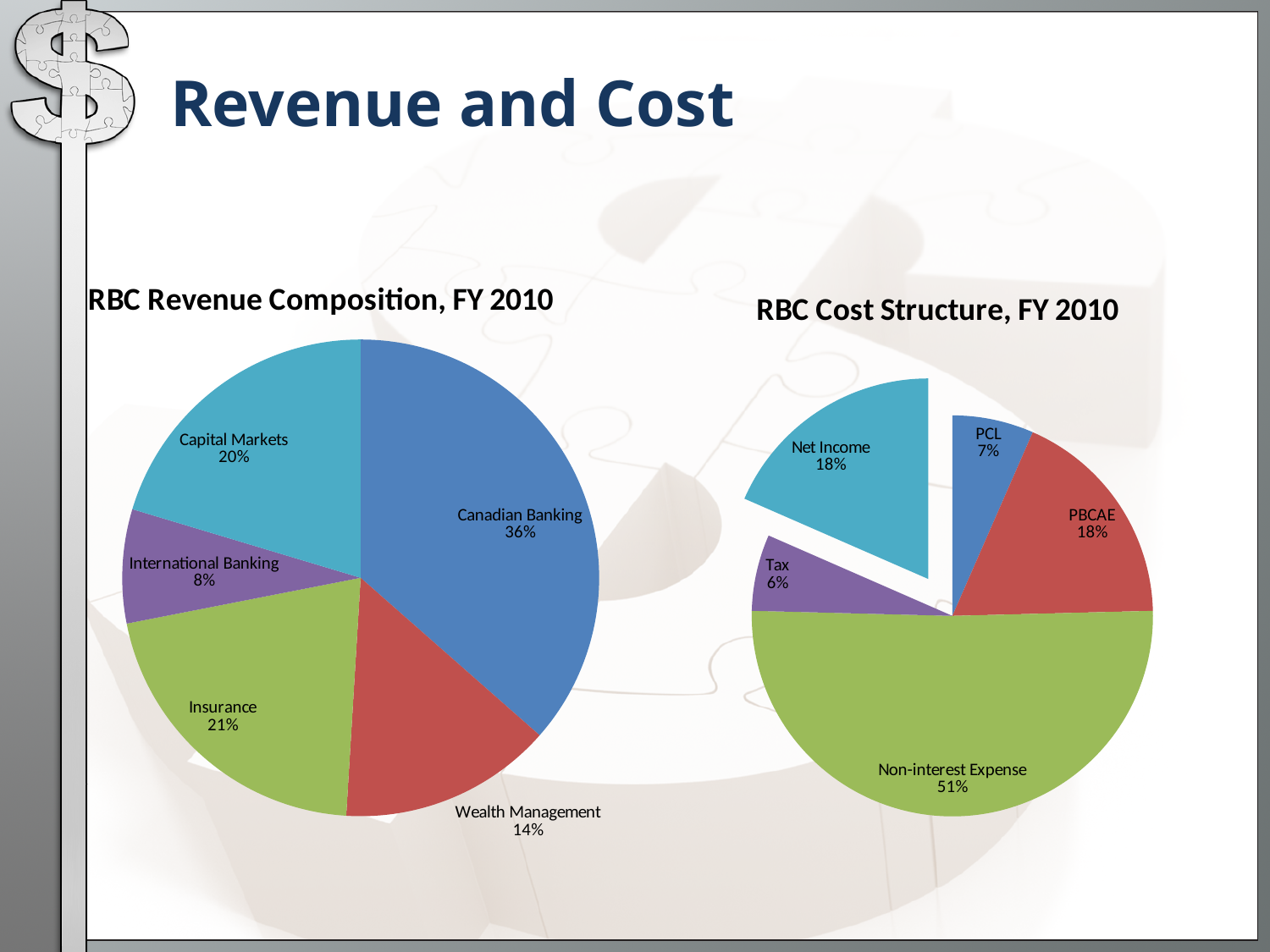
In the RBC Cost Structure, FY 2010 chart, which is larger, Net Income or Tax? Net Income In the RBC Cost Structure, FY 2010 chart, what is the difference between Non-interest Expense and PBCAE? 33% In the RBC Revenue Composition, FY 2010 chart, which segment has the largest share? Canadian Banking In the RBC Revenue Composition, FY 2010 chart, which segment has the smallest share? International Banking In the RBC Revenue Composition, FY 2010 chart, what share does Canadian Banking have? 36% In the RBC Revenue Composition, FY 2010 chart, what is the value for Wealth Management? 14% In the RBC Revenue Composition, FY 2010 chart, what is the difference between Insurance and Capital Markets? 1% What type of chart is the RBC Cost Structure, FY 2010 chart? Pie chart In the RBC Revenue Composition, FY 2010 chart, how many segments are shown? 5 In the RBC Cost Structure, FY 2010 chart, what share does Non-interest Expense have? 51% In the RBC Cost Structure, FY 2010 chart, which segment is the smallest? Tax In the RBC Cost Structure, FY 2010 chart, what is the value for PCL? 7%